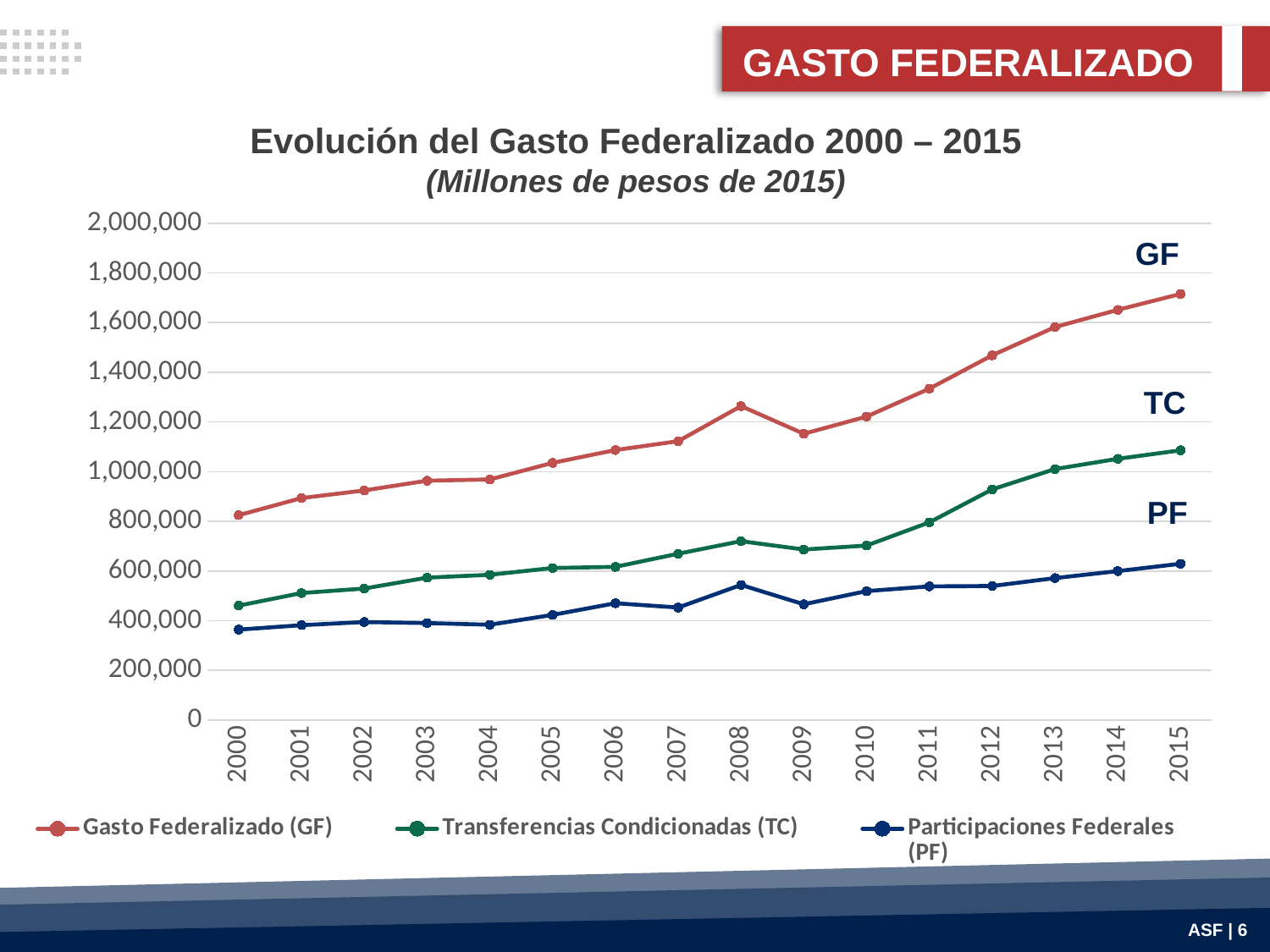
Which series has the larger value in 2010, Gasto Federalizado (GF) or Transferencias Condicionadas (TC)? Gasto Federalizado (GF) How many years are plotted along the x axis? 16 In which year is the Participaciones Federales (PF) series at its highest? 2015 Does the Gasto Federalizado (GF) series generally rise or fall from 2000 to 2015? rise Is the value for Gasto Federalizado (GF) in 2009 greater or less than 1,200,000? less Is the value for Participaciones Federales (PF) in 2000 greater or less than 400,000? less How many series does the legend list? 3 In which year is the Gasto Federalizado (GF) series at its lowest? 2000 What kind of chart is shown on the slide? line chart Is the value for Transferencias Condicionadas (TC) in 2000 greater or less than 600,000? less In which year is the Gasto Federalizado (GF) series at its highest? 2015